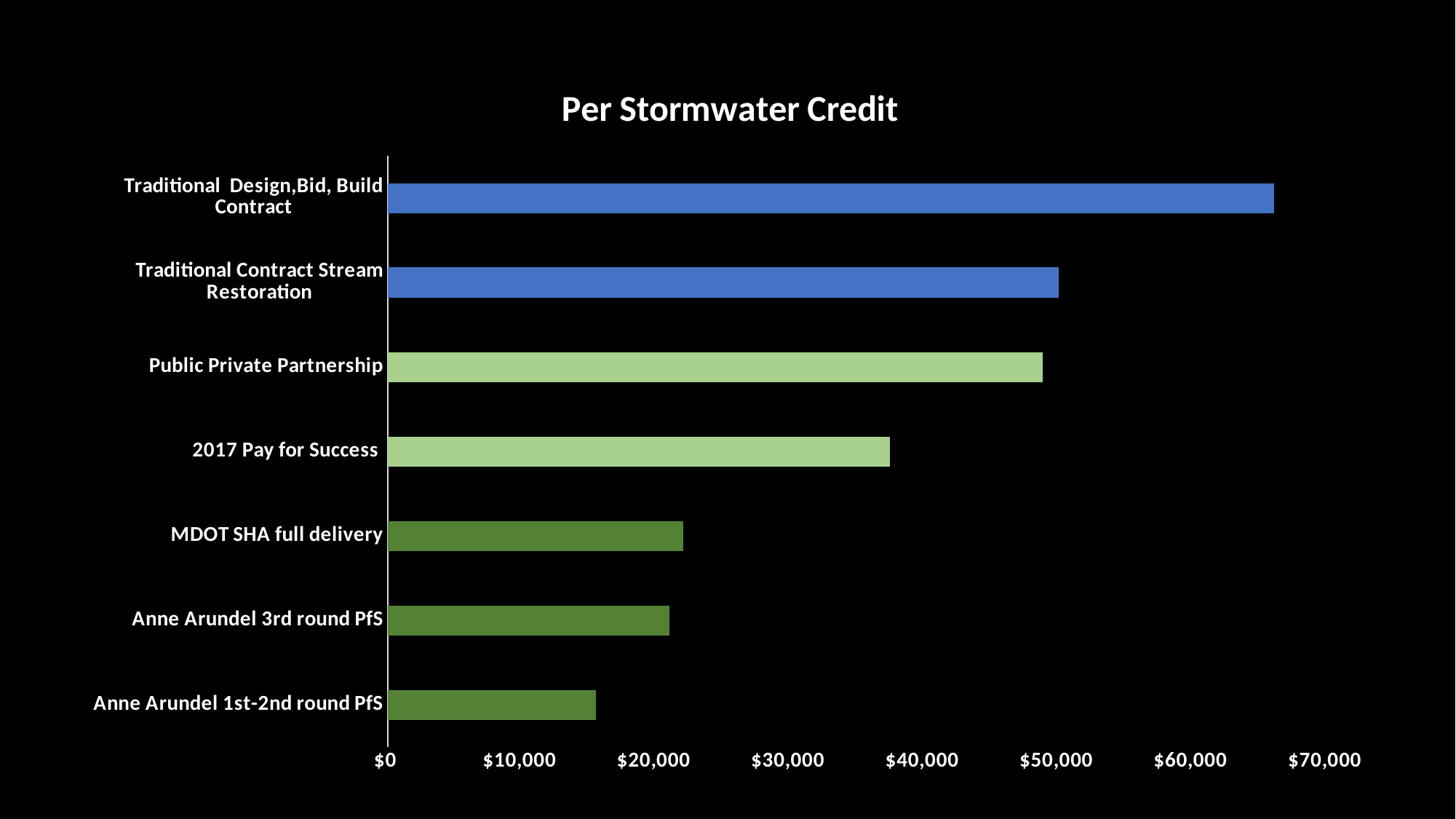
What type of chart is shown on the slide? bar chart Which is larger, the value for MDOT SHA full delivery or the value for Anne Arundel 1st-2nd round PfS? MDOT SHA full delivery Do the bar values increase or decrease going from the top category to the bottom category? decrease Is the value for Traditional Design,Bid, Build Contract greater or less than $60,000? greater Is the value for MDOT SHA full delivery greater or less than $30,000? less Is the value for 2017 Pay for Success greater or less than $40,000? less How many categories are plotted in the chart? 7 What is the title of the chart? Per Stormwater Credit Which is larger, the value for Traditional Contract Stream Restoration or the value for 2017 Pay for Success? Traditional Contract Stream Restoration Which category has the highest value per stormwater credit? Traditional Design,Bid, Build Contract Which category has the lowest value per stormwater credit? Anne Arundel 1st-2nd round PfS